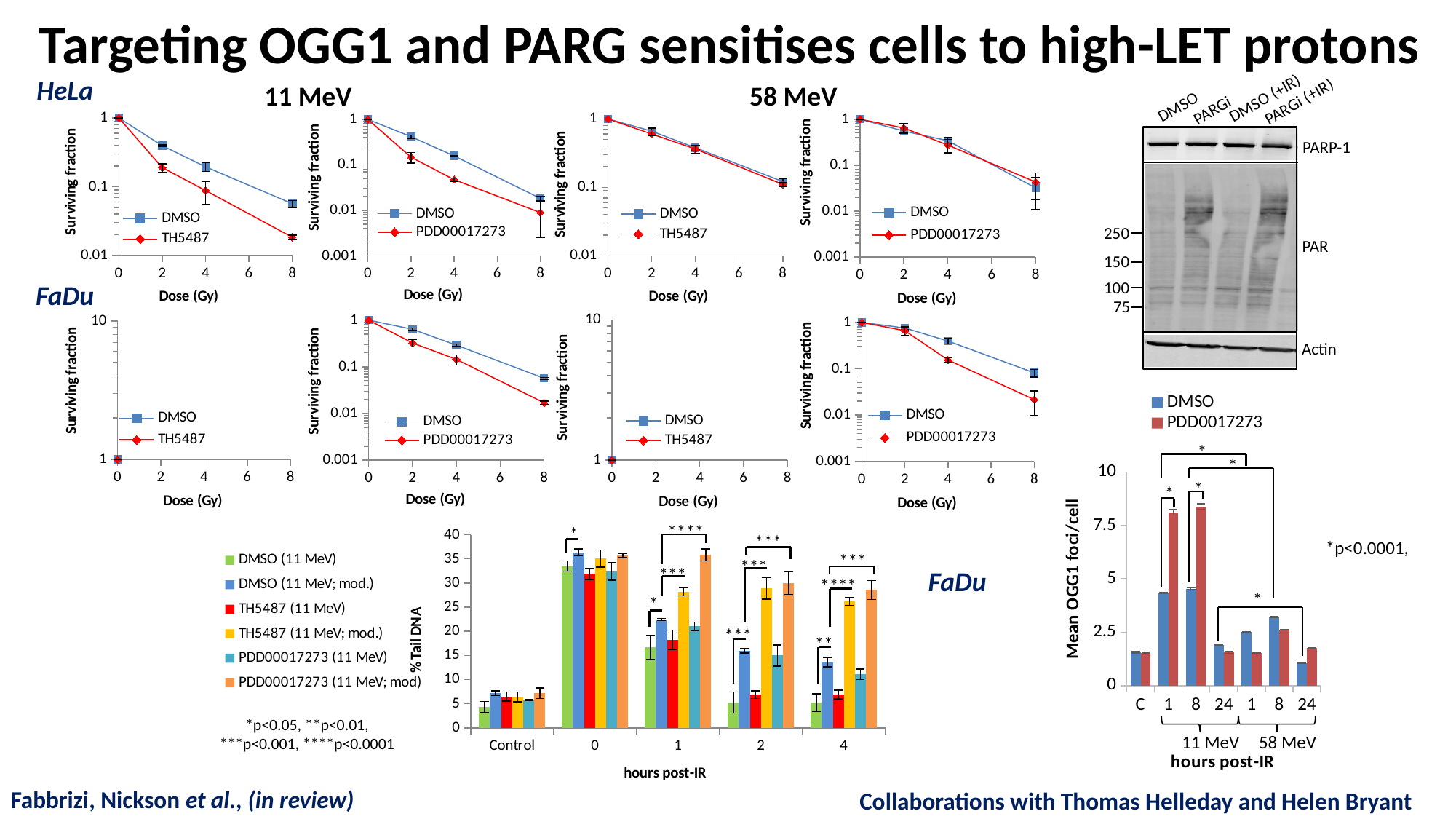
In the Mean OGG1 foci/cell chart at 1 hour (11 MeV), which is higher, DMSO or PDD0017273? PDD0017273 In the HeLa 11 MeV DMSO vs TH5487 chart, is the surviving fraction for TH5487 at 8 Gy greater or less than 0.1? less In the Mean OGG1 foci/cell chart, is the value for PDD0017273 at 8 hours (11 MeV) greater or less than 7.5? greater What kind of chart is the HeLa 11 MeV DMSO vs TH5487 chart? line chart How many series does the legend of the Mean OGG1 foci/cell chart list? 2 In the HeLa 11 MeV DMSO vs TH5487 chart, does the surviving fraction rise or fall as dose increases? fall How many categories are shown on the x axis of the % Tail DNA chart? 5 In the % Tail DNA chart, which series has the highest value at 1 hour post-IR? PDD00017273 (11 MeV; mod) How many series does the legend of the % Tail DNA bar chart list? 6 How many categories are shown on the x axis of the Mean OGG1 foci/cell chart? 7 What kind of chart is the % Tail DNA chart? bar chart In the % Tail DNA chart, is the value for DMSO (11 MeV; mod.) at 0 hours greater or less than 30? greater